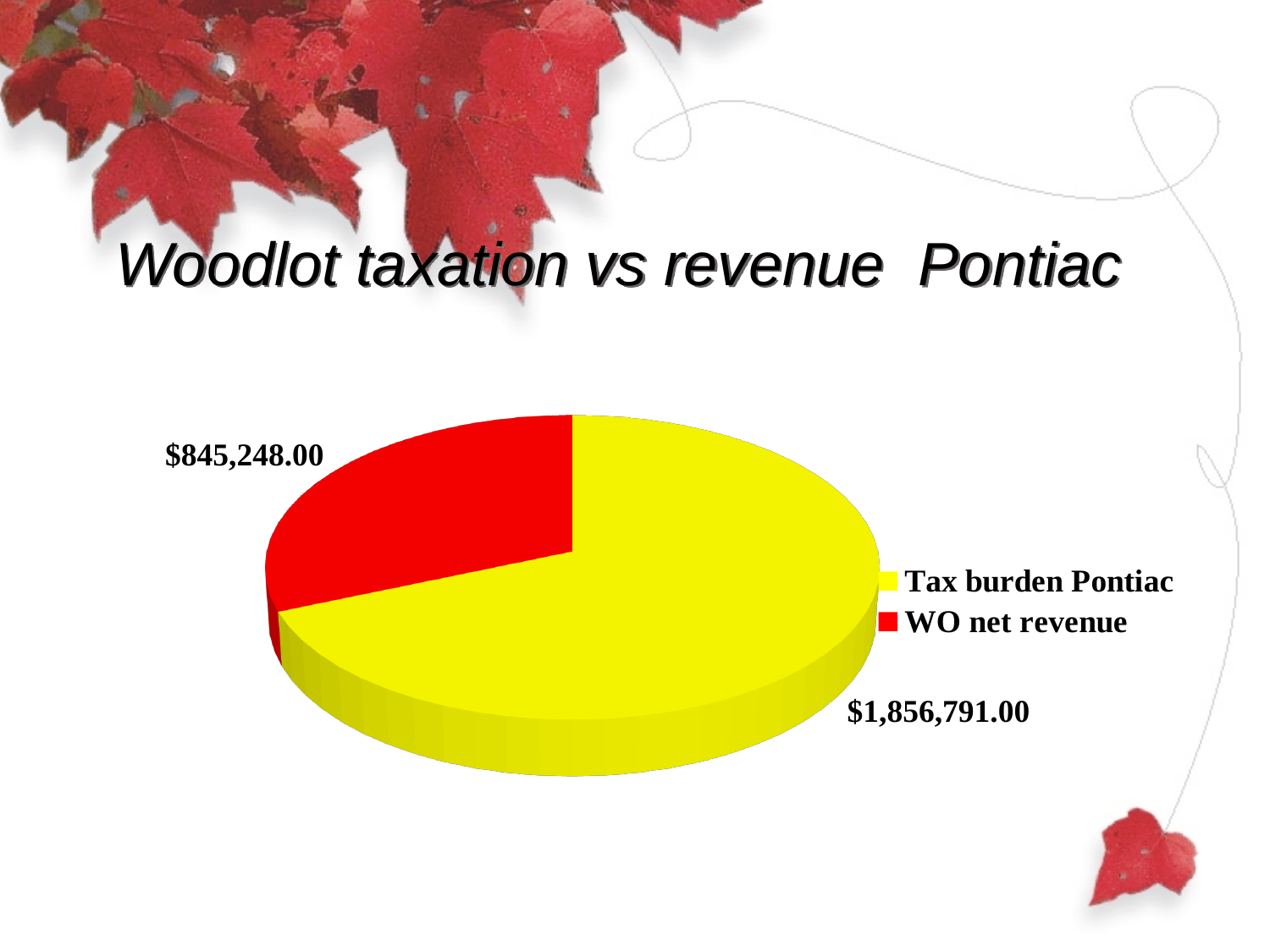
What is the total of the two slices? $2,702,039.00 Which slice is the smallest? WO net revenue What is the title of the slide? Woodlot taxation vs revenue Pontiac What share of the pie does Tax burden Pontiac represent? 68.7% Which is larger, Tax burden Pontiac or WO net revenue? Tax burden Pontiac Which slice is the largest? Tax burden Pontiac What is the difference between Tax burden Pontiac and WO net revenue? $1,011,543.00 What is the value for Tax burden Pontiac? $1,856,791.00 What kind of chart is shown on the slide? Pie chart What colour is the WO net revenue slice? Red How many slices does the pie chart have? 2 What is the value for WO net revenue? $845,248.00